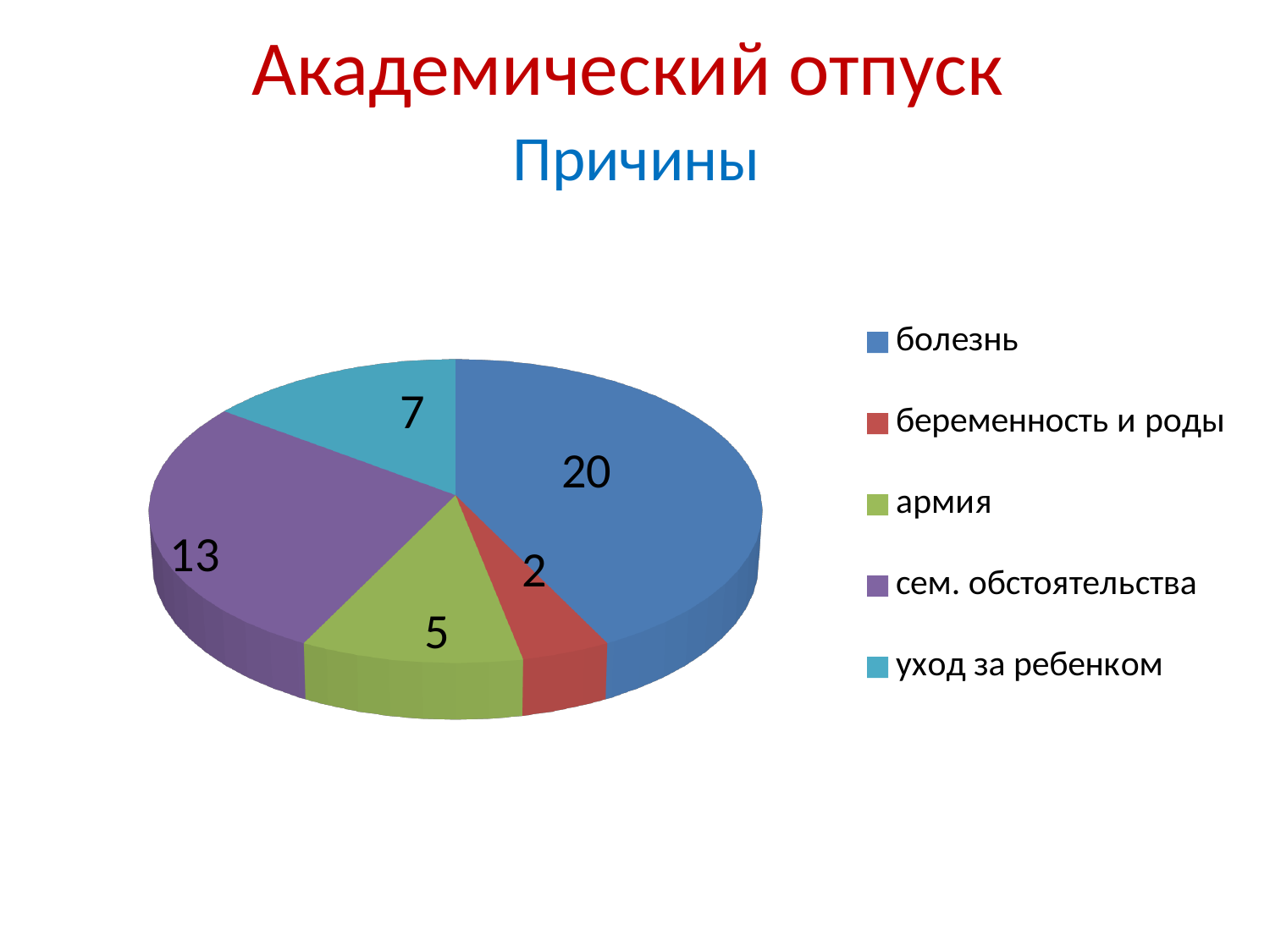
What is the value for болезнь in the pie chart? 20 What is the value for сем. обстоятельства in the pie chart? 13 Which is larger, the value for армия or the value for уход за ребенком? уход за ребенком What kind of chart is shown on the slide? pie chart What is the subtitle shown above the pie chart? Причины What is the total of all the values in the pie chart? 47 What is the value for уход за ребенком in the pie chart? 7 Which category has the smallest slice in the pie chart? беременность и роды How many categories are shown in the pie chart? 5 Which category has the largest slice in the pie chart? болезнь What is the value for армия in the pie chart? 5 What is the difference between the values for болезнь and сем. обстоятельства? 7